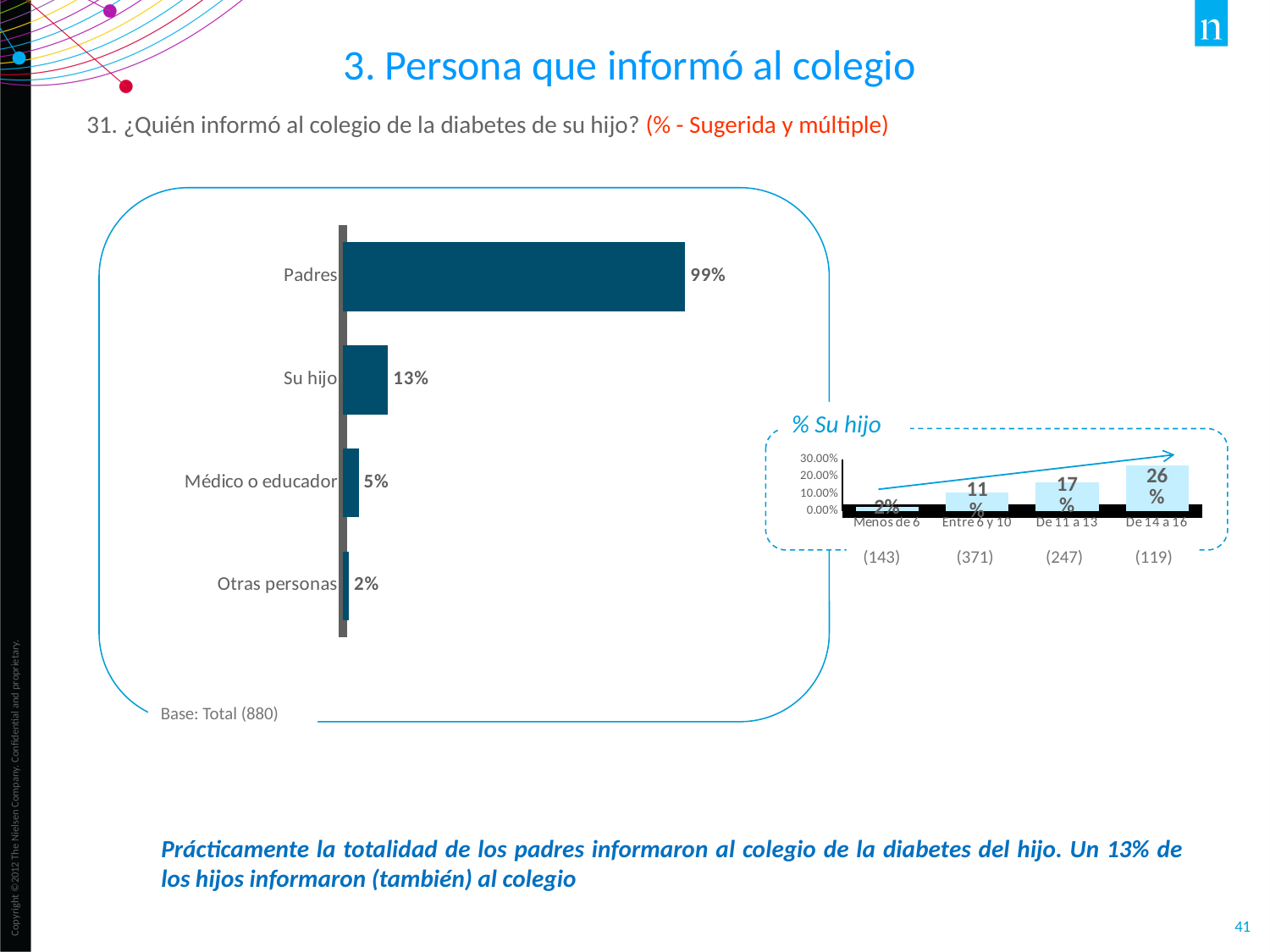
In the main bar chart on the left, what percentage is shown for Médico o educador? 5% In the '% Su hijo' chart, what value is shown for De 14 a 16? 26% In the main bar chart on the left, how many categories are shown? 4 In the '% Su hijo' chart, do the values rise or fall from Menos de 6 to De 14 a 16? Rise In the '% Su hijo' chart, what is the difference between the values for De 11 a 13 and Menos de 6? 15% In the main bar chart on the left, what is the difference between the values for Padres and Su hijo? 86% In the '% Su hijo' chart, what value is shown for Entre 6 y 10? 11% What kind of chart is the main chart on the left? Bar chart In the main bar chart on the left, which category has the highest value? Padres In the main bar chart on the left, which category has the lowest value? Otras personas In the main bar chart on the left, what percentage is shown for Padres? 99% In the main bar chart on the left, what percentage is shown for Su hijo? 13%